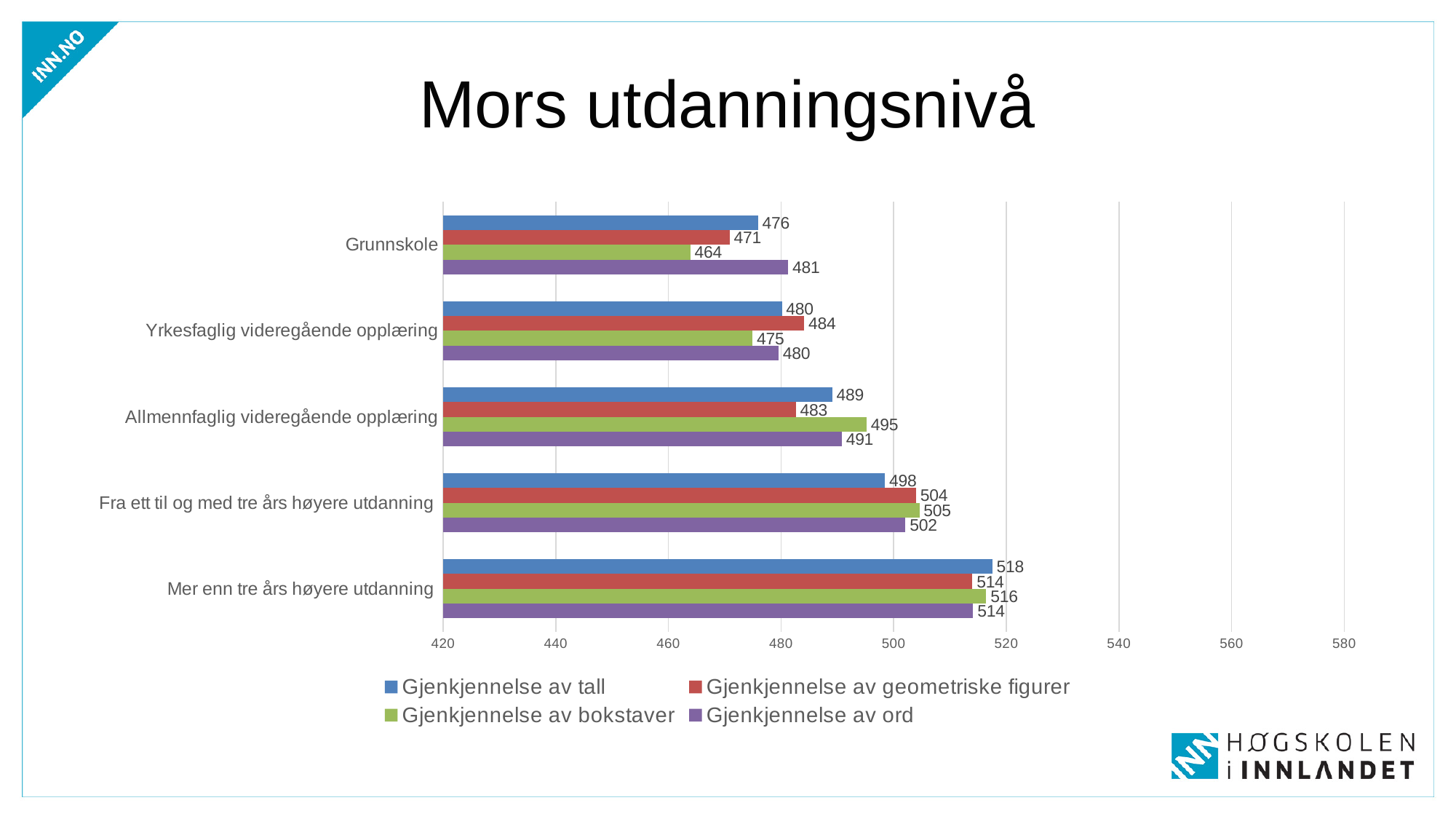
Which category has the highest value for Gjenkjennelse av tall? Mer enn tre års høyere utdanning How many education-level categories are shown on the chart? 5 Which is larger for Yrkesfaglig videregående opplæring: Gjenkjennelse av geometriske figurer or Gjenkjennelse av bokstaver? Gjenkjennelse av geometriske figurer What is the value of Gjenkjennelse av bokstaver for Allmennfaglig videregående opplæring? 495 Which category has the lowest value for Gjenkjennelse av bokstaver? Grunnskole What is the difference between Gjenkjennelse av tall for Mer enn tre års høyere utdanning and for Grunnskole? 42 What is the value of Gjenkjennelse av tall for Grunnskole? 476 Is the value of Gjenkjennelse av ord for Grunnskole greater or less than 500? less What kind of chart is shown on the slide? Bar chart How many series does the legend list? 4 What is the title of the chart? Mors utdanningsnivå What is the value of Gjenkjennelse av ord for Fra ett til og med tre års høyere utdanning? 502